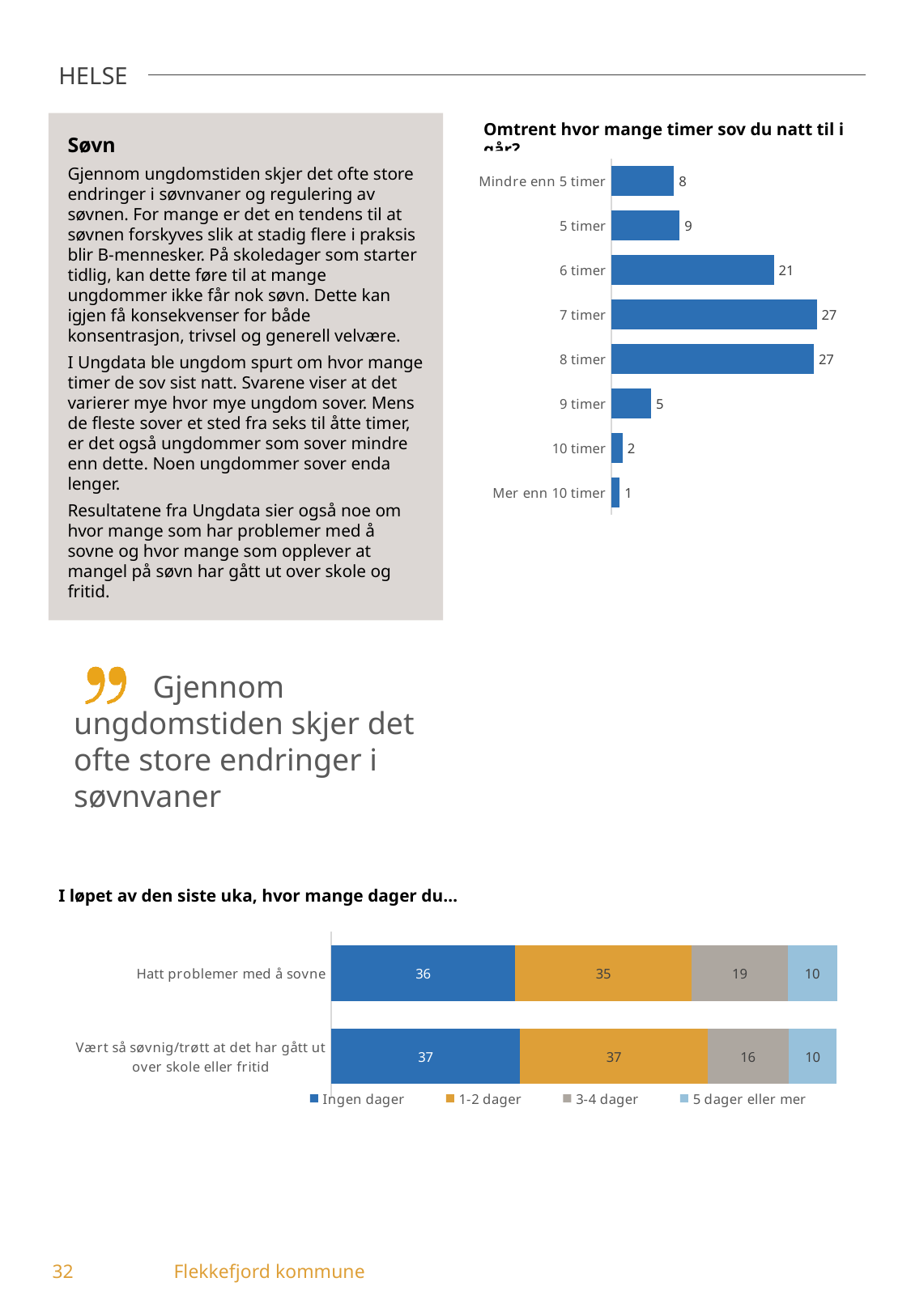
What kind of chart is the top-right chart (Omtrent hvor mange timer sov du natt til i går?)? Bar chart In the bottom chart (I løpet av den siste uka, hvor mange dager du…), what is the value for 3-4 dager for 'Vært så søvnig/trøtt at det har gått ut over skole eller fritid'? 16 How many categories are shown in the top-right chart (Omtrent hvor mange timer sov du natt til i går?)? 8 In the top-right chart (Omtrent hvor mange timer sov du natt til i går?), which is larger: the value for 5 timer or the value for 10 timer? 5 timer In the top-right chart (Omtrent hvor mange timer sov du natt til i går?), which category has the lowest value? Mer enn 10 timer In the bottom chart (I løpet av den siste uka, hvor mange dager du…), what is the total of the stacked bar for 'Hatt problemer med å sovne'? 100 In the top-right chart (Omtrent hvor mange timer sov du natt til i går?), what is the difference between the values for 7 timer and 9 timer? 22 In the bottom chart (I løpet av den siste uka, hvor mange dager du…), which legend entry is shown in orange? 1-2 dager In the bottom chart (I løpet av den siste uka, hvor mange dager du…), what is the value for Ingen dager for 'Hatt problemer med å sovne'? 36 In the top-right chart (Omtrent hvor mange timer sov du natt til i går?), what is the value for 6 timer? 21 In the top-right chart (Omtrent hvor mange timer sov du natt til i går?), what is the value for Mindre enn 5 timer? 8 How many series does the legend of the bottom chart (I løpet av den siste uka, hvor mange dager du…) list? 4